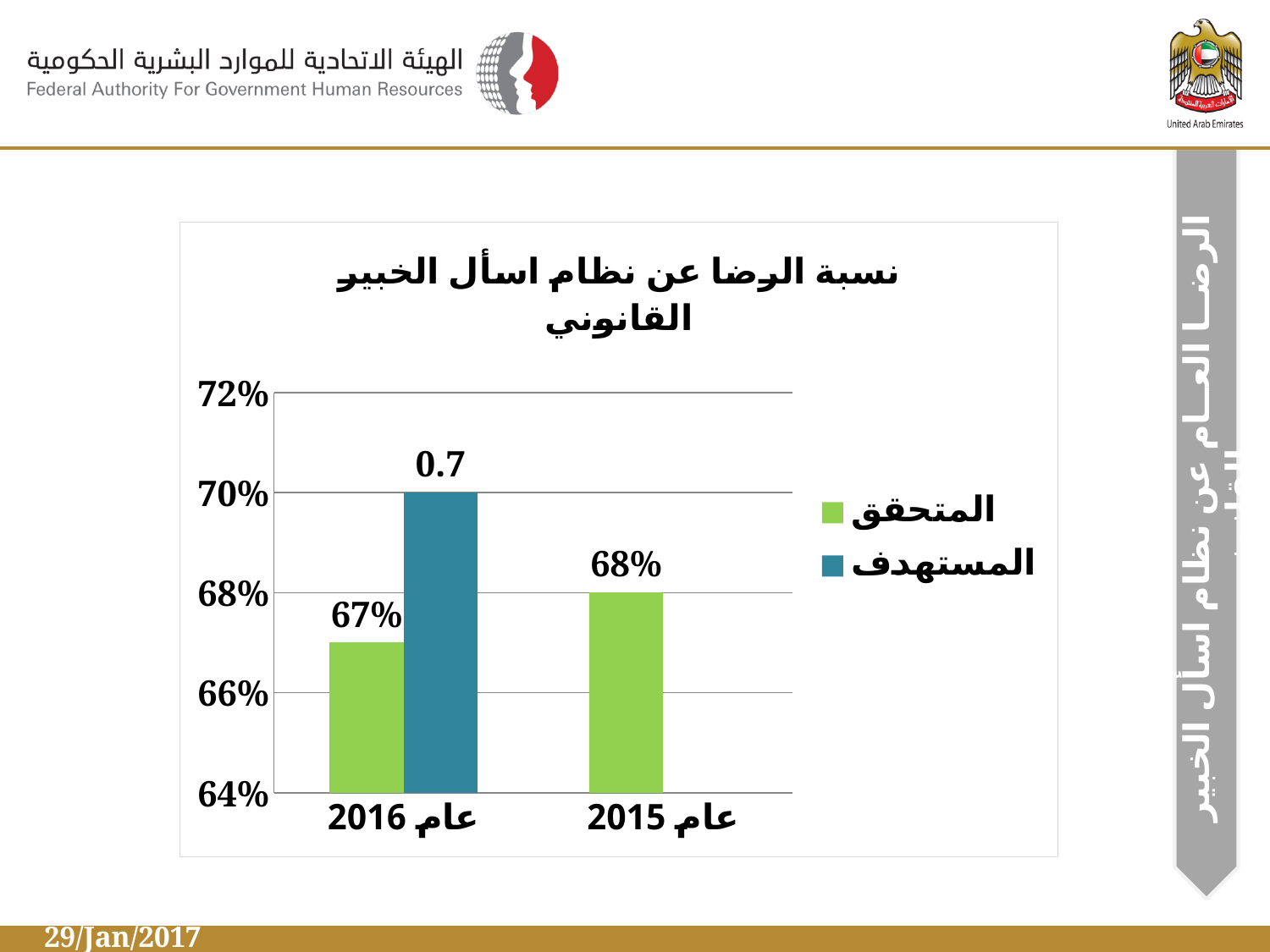
How many year categories are shown on the x axis? 2 Which series is shown in green in the legend? المتحقق What kind of chart is shown on the slide? Bar chart Is the المستهدف bar for عام 2016 greater or less than 68%? greater What data label is shown on the المستهدف bar for عام 2016? 0.7 Which year has the higher المتحقق value, عام 2016 or عام 2015? عام 2015 How many series does the legend list? 2 What is the title of the chart? نسبة الرضا عن نظام اسأل الخبير القانوني What is the difference between the المتحقق values for عام 2015 and عام 2016? 1% What is the value of المتحقق for عام 2016? 67% What is the value of المتحقق for عام 2015? 68% Is the المتحقق bar for عام 2016 greater or less than 68%? less